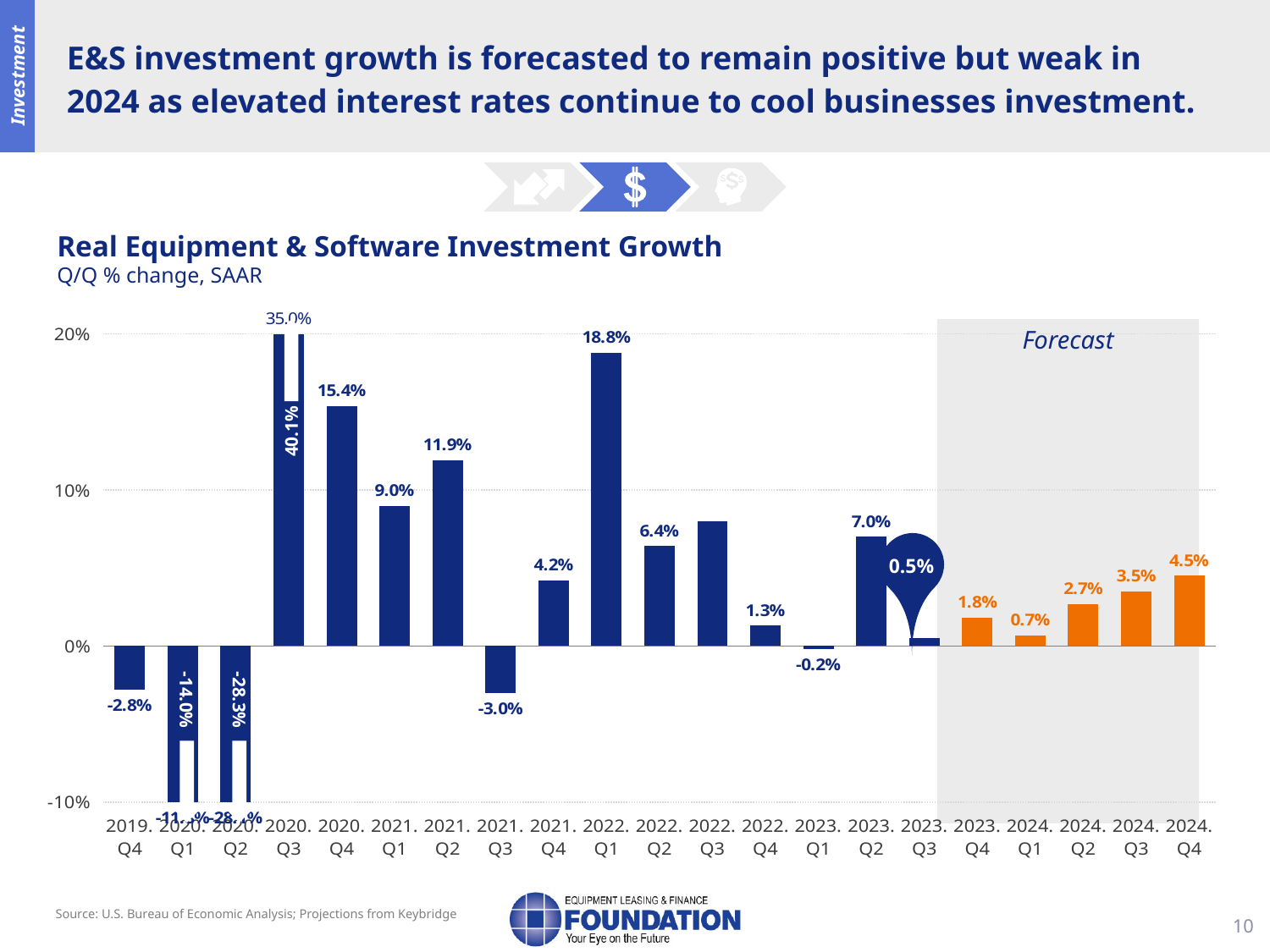
Among the forecast quarters (2023 Q4 through 2024 Q4), which has the lowest value? 2024 Q1 What is the value for 2021 Q3? -3.0% What is the difference between the values for 2024 Q4 and 2024 Q1? 3.8% Is the value for 2022 Q3 greater or less than 10%? less Among the forecast quarters (2023 Q4 through 2024 Q4), which has the highest value? 2024 Q4 What is the value for 2023 Q1? -0.2% What is the value for 2023 Q2? 7.0% Do the forecast values rise or fall from 2024 Q1 to 2024 Q4? rise What is the forecast value for 2024 Q4? 4.5% What kind of chart is shown on the slide? bar chart Which is larger, the value for 2020 Q4 or the value for 2021 Q2? 2020 Q4 What is the value for 2022 Q1? 18.8%